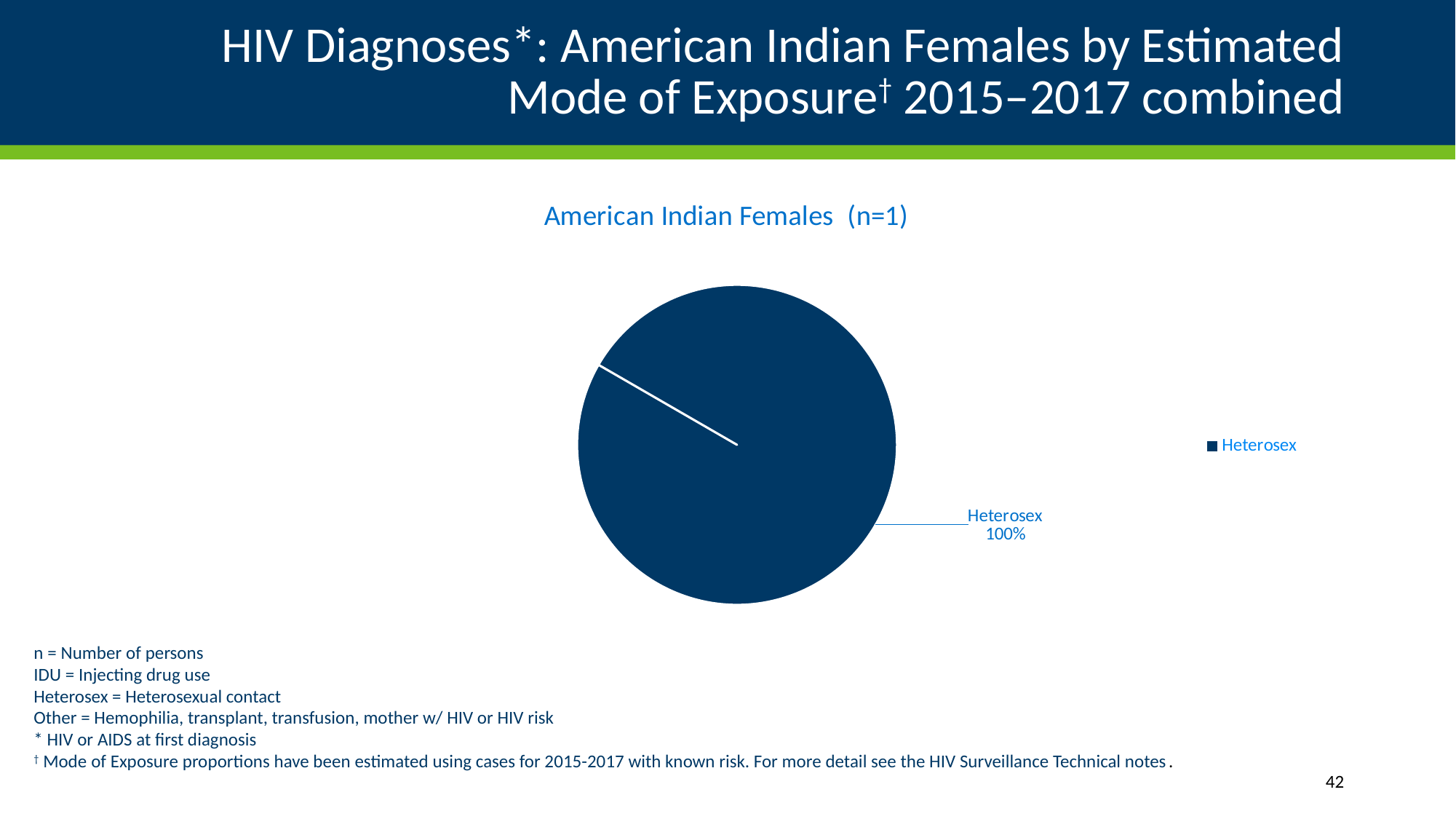
Which category has the largest share of the pie? Heterosex What kind of chart is shown on the slide? pie chart What share of the pie does the Heterosex slice represent? 100% How many slices does the pie chart have? 1 How many entries does the legend list? 1 What is the value printed for the Heterosex slice? 100% Which mode of exposure category is shown in the pie chart? Heterosex What is the title of the chart? American Indian Females (n=1)